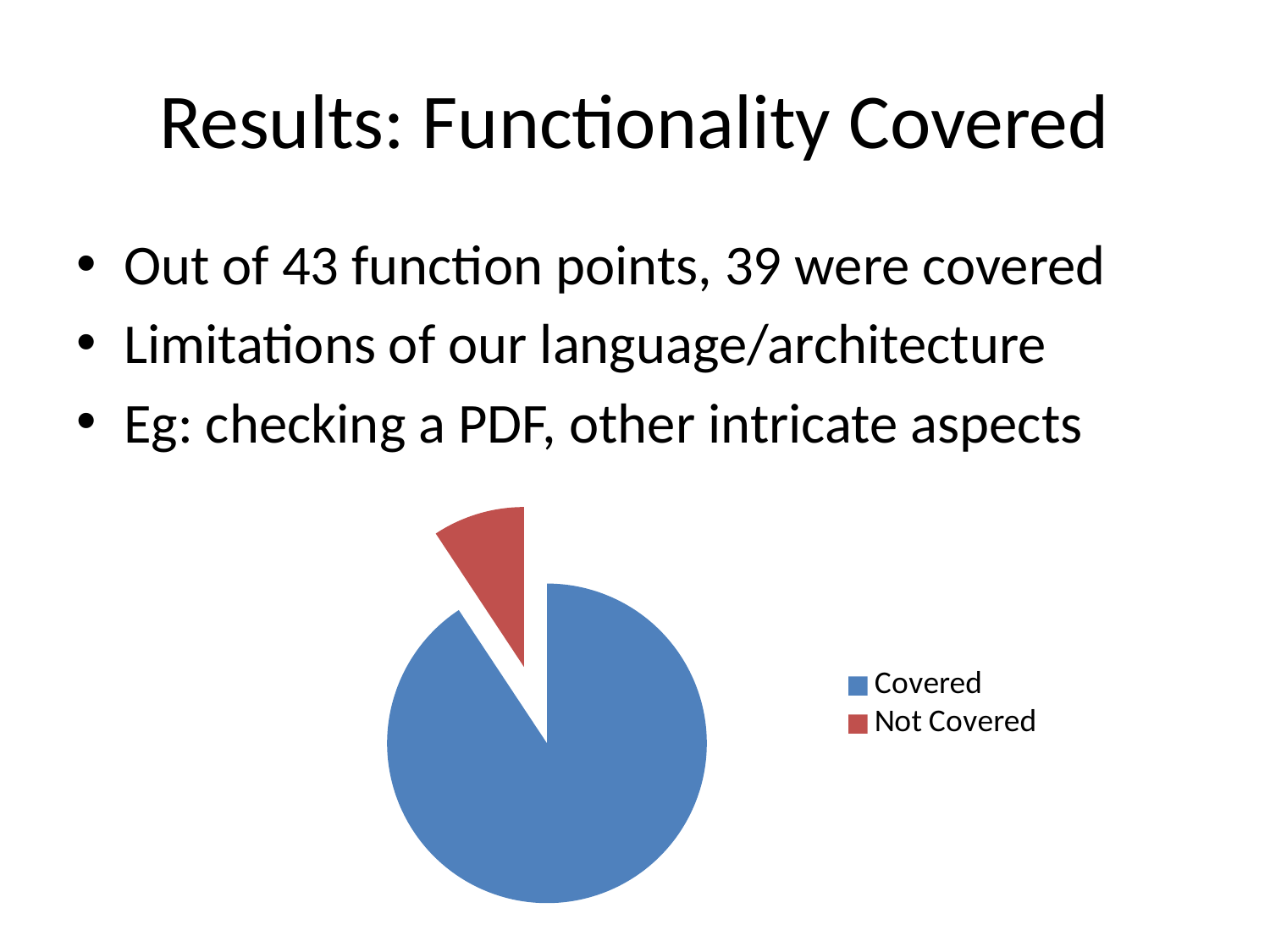
Which slice is larger in the pie chart, Covered or Not Covered? Covered Which legend entry is shown in red in the pie chart? Not Covered What kind of chart is shown on the slide? pie chart How many slices does the pie chart have? 2 Which slice of the pie chart is the smallest? Not Covered How many entries does the legend of the pie chart list? 2 What colour is the Covered slice in the pie chart? blue Which slice of the pie chart is the largest? Covered